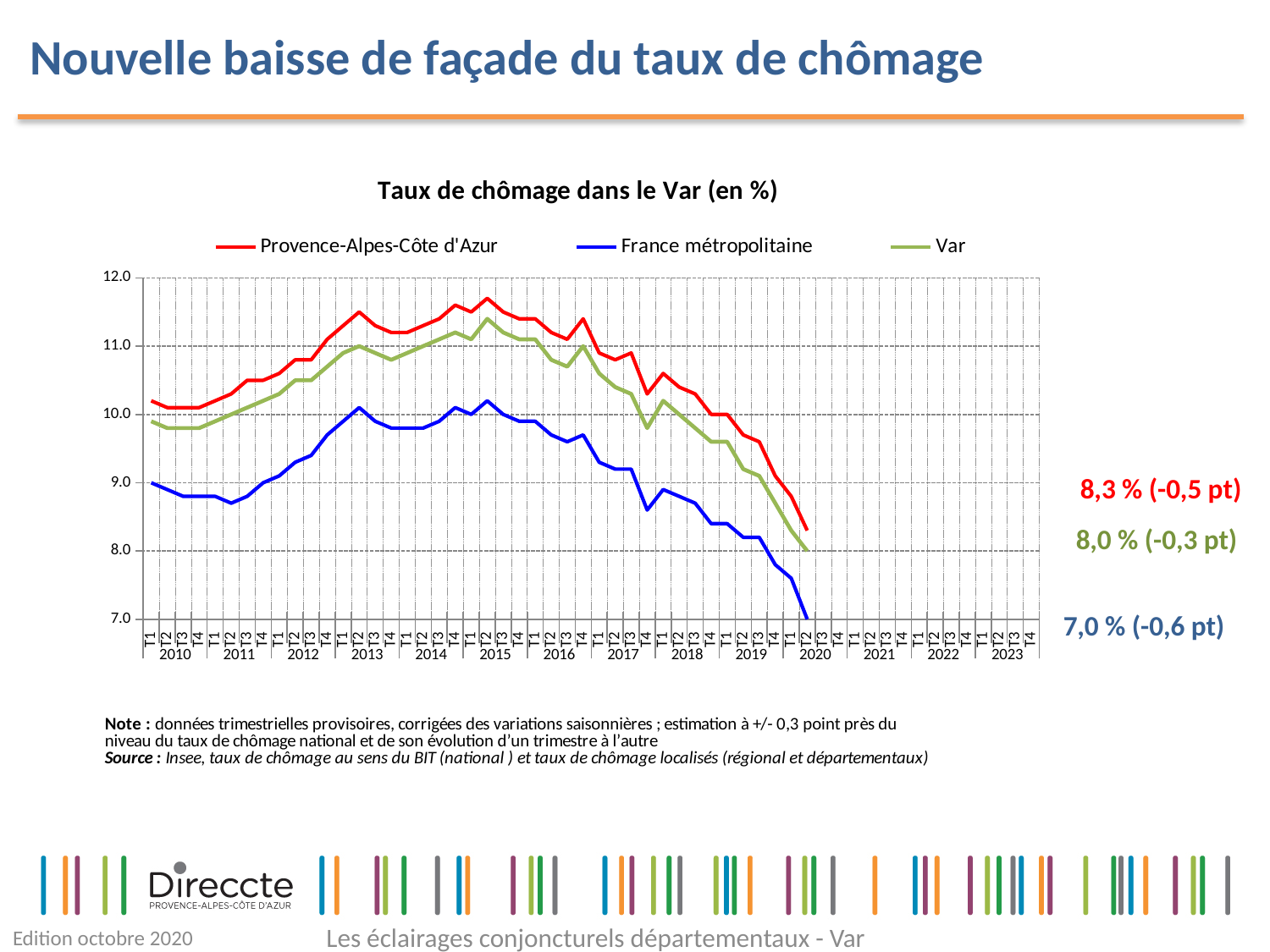
Is the value for Provence-Alpes-Côte d'Azur in T2 2015 greater or less than 11.0? greater How many series does the legend list? 3 By how many points did the France métropolitaine rate change in the latest quarter, according to the annotation? -0,6 pt What is the difference between the latest Provence-Alpes-Côte d'Azur rate and the latest Var rate? 0,3 What is the latest unemployment rate shown for France métropolitaine? 7,0 % What is the latest unemployment rate shown for the Var? 8,0 % Which series has the lowest values across the whole period? France métropolitaine Do the unemployment rates rise or fall between 2015 and 2020? fall What kind of chart is shown on the slide? line chart What is the title of the chart? Taux de chômage dans le Var (en %) Which series has the highest values across the whole period? Provence-Alpes-Côte d'Azur What is the latest unemployment rate shown for Provence-Alpes-Côte d'Azur? 8,3 %